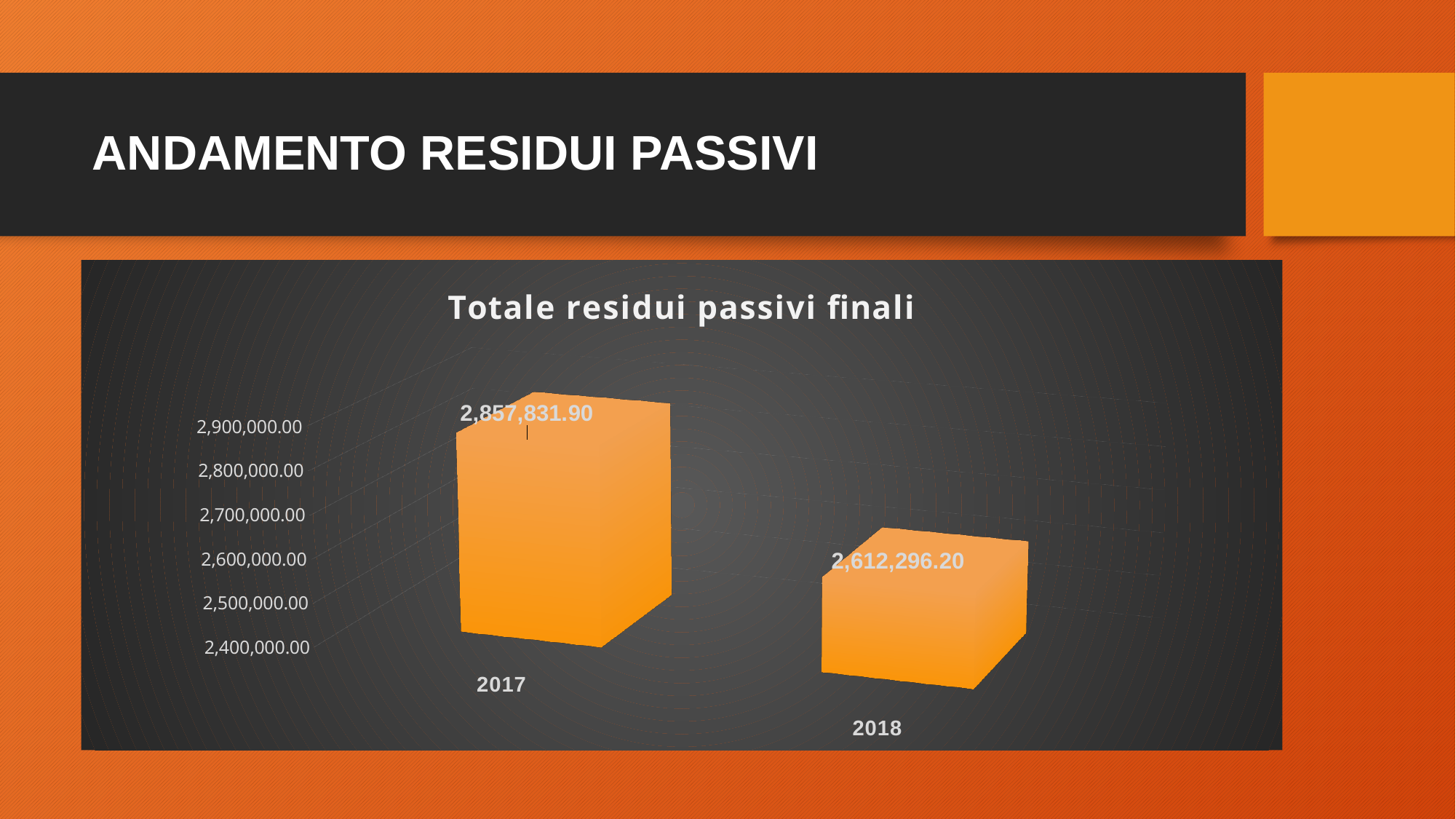
Is the value for 2017 greater or less than 2,800,000.00? greater What is the difference between the values for 2017 and 2018? 245,535.70 What kind of chart is shown on the slide? Bar chart What is the value for 2017? 2,857,831.90 What is the title of the chart? Totale residui passivi finali Which year has the highest value? 2017 How many years are shown on the chart? 2 Is the value for 2018 greater or less than 2,700,000.00? less What is the value for 2018? 2,612,296.20 Which is larger, the value for 2017 or the value for 2018? 2017 Which year has the lowest value? 2018 Do the values rise or fall from 2017 to 2018? Fall